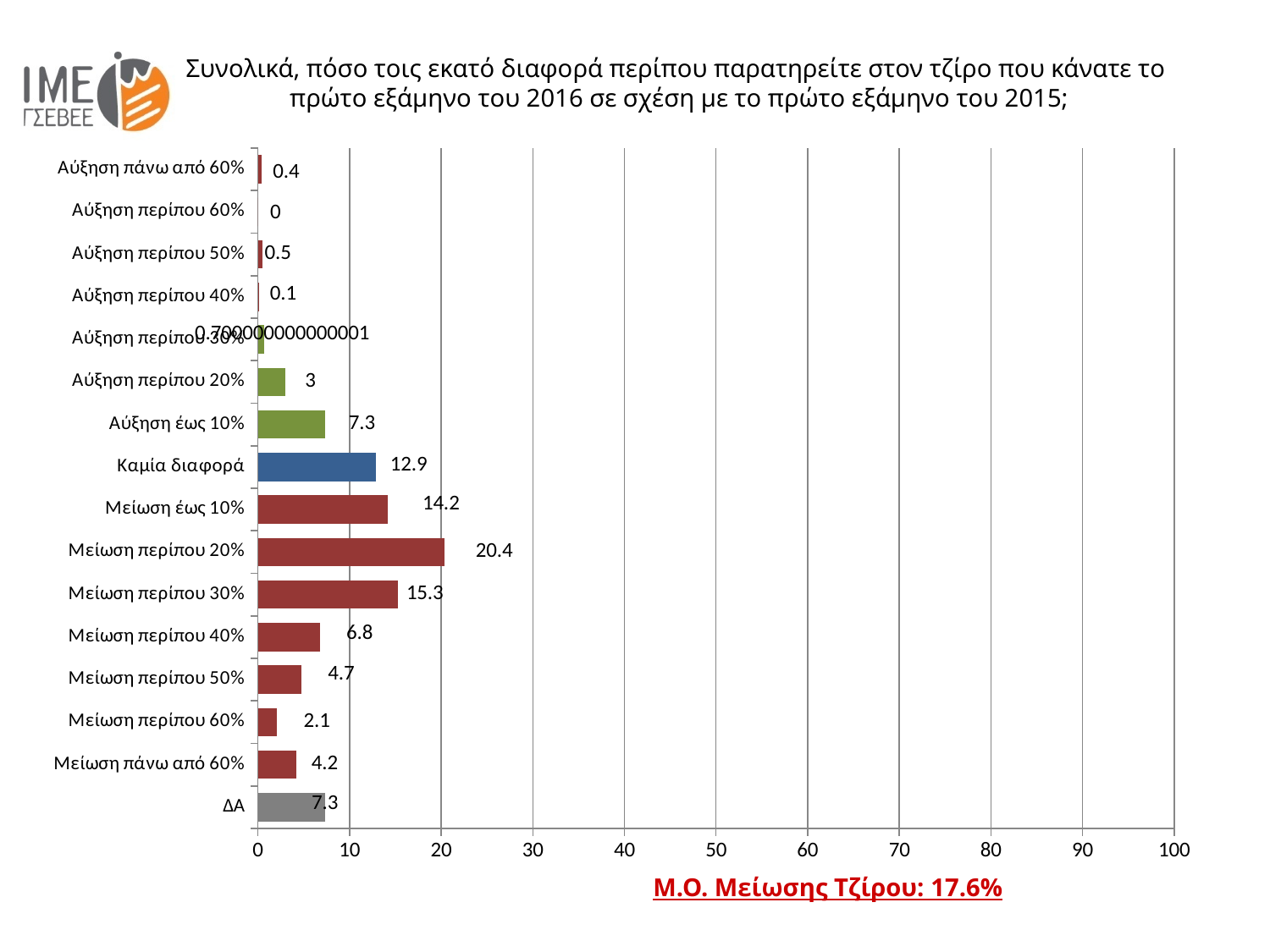
Which category has the lowest value? Αύξηση περίπου 60% What value is shown for Καμία διαφορά? 12.9 Which is larger, the value for Μείωση έως 10% or the value for Καμία διαφορά? Μείωση έως 10% What is the difference between the values for Μείωση περίπου 20% and Μείωση περίπου 30%? 5.1 Is the value for Μείωση περίπου 30% greater or less than 10? greater What value is shown for ΔΑ? 7.3 What value is shown for Μείωση πάνω από 60%? 4.2 What value is shown for Μείωση περίπου 20%? 20.4 What kind of chart is shown on the slide? bar chart How many categories are shown on the chart? 16 What average turnover decrease (Μ.Ο. Μείωσης Τζίρου) is stated below the chart? 17.6% Which category has the highest value? Μείωση περίπου 20%